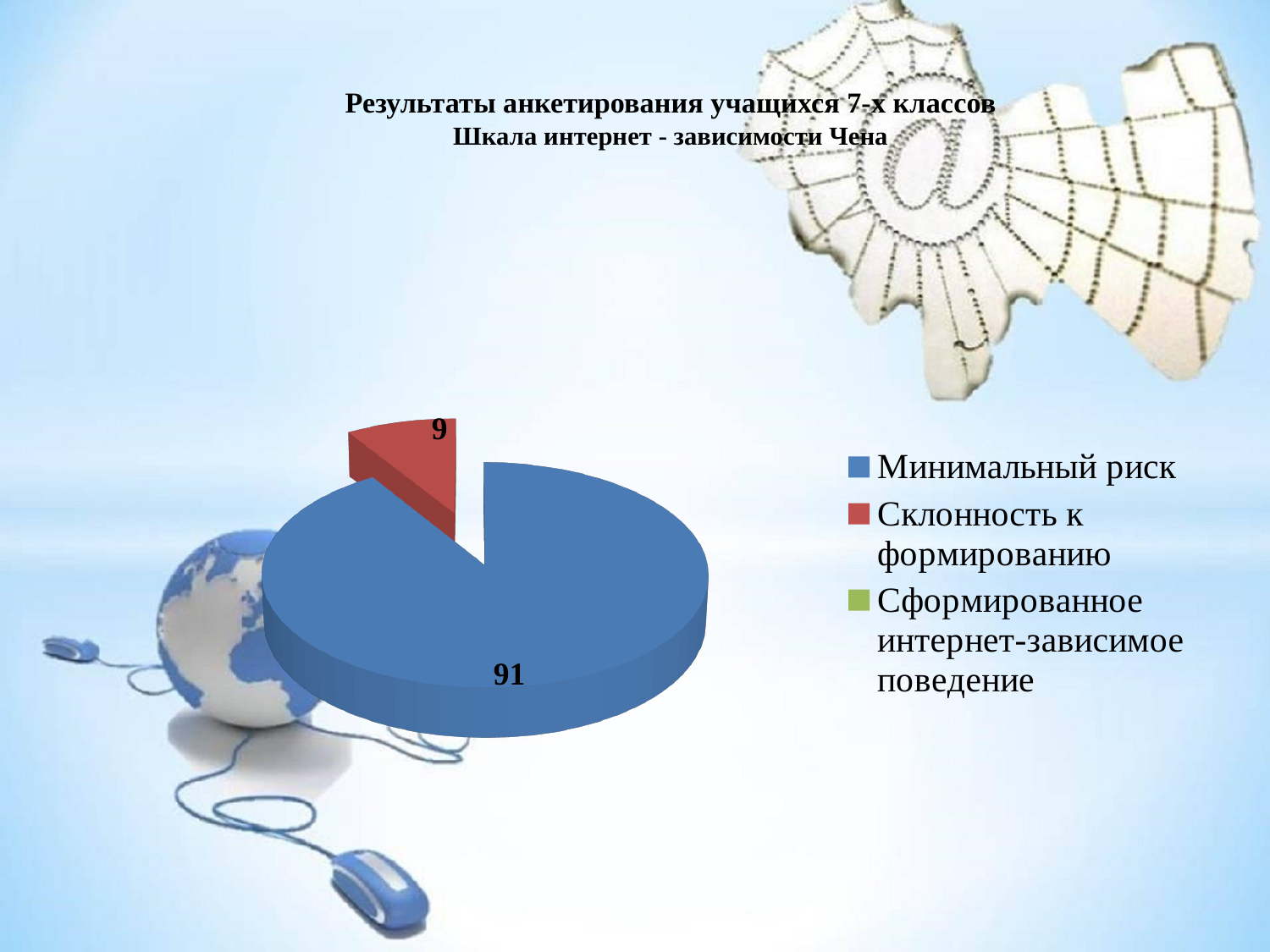
What value is shown for the "Склонность к формированию" slice of the pie chart? 9 What colour is the "Минимальный риск" slice in the pie chart? Blue What kind of chart is shown on the slide? Pie chart What is the difference between the values of the "Минимальный риск" and "Склонность к формированию" slices? 82 Which of the labelled slices in the pie chart is the smallest? Склонность к формированию How many slices with data labels are visible in the pie chart? 2 Which is larger: the value for "Минимальный риск" or the value for "Склонность к формированию"? Минимальный риск What value is shown for the "Минимальный риск" slice of the pie chart? 91 Which legend entry is shown in green? Сформированное интернет-зависимое поведение How many entries does the legend of the pie chart list? 3 Which category has the largest slice in the pie chart? Минимальный риск